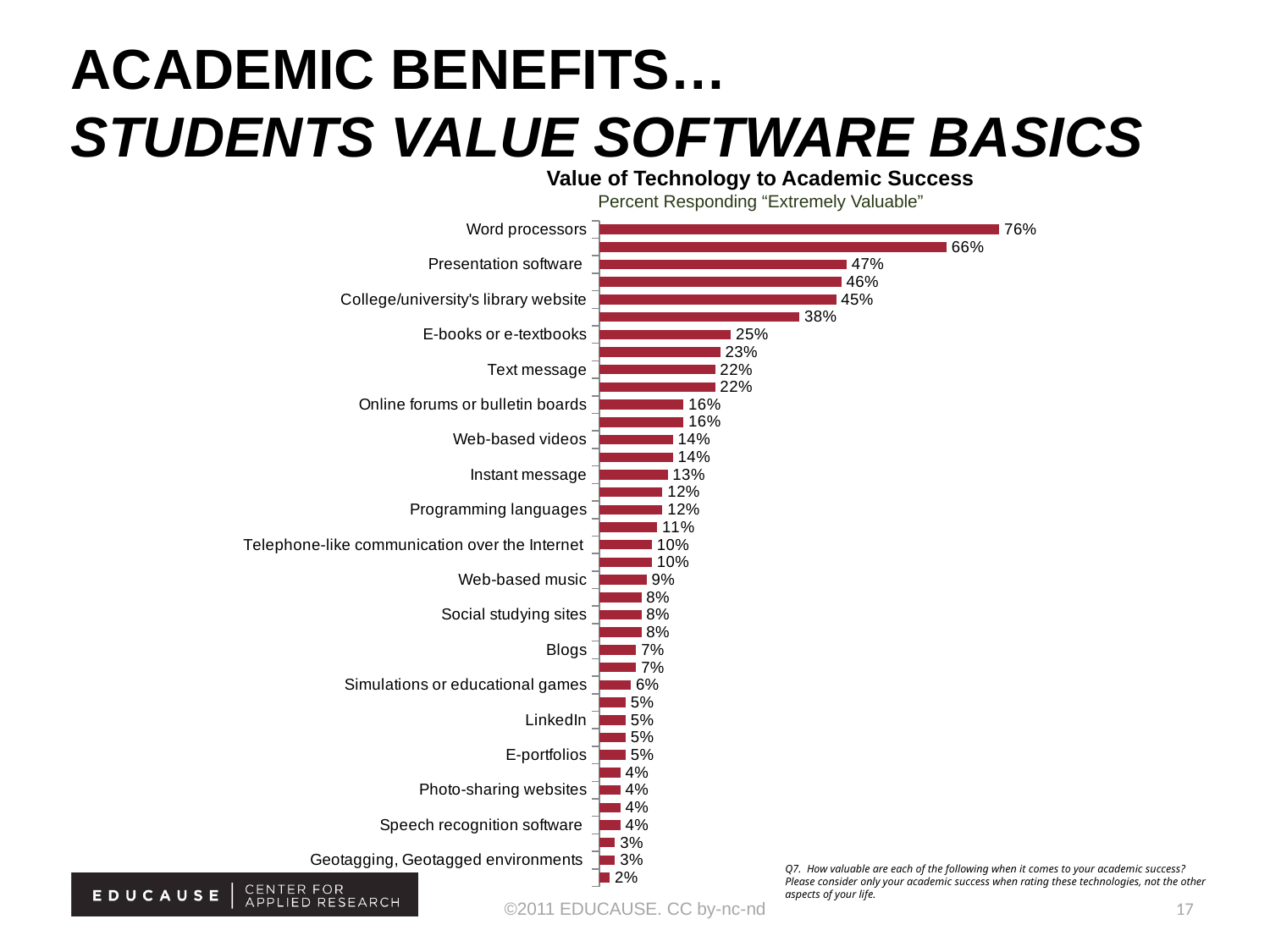
How many percentage points higher is word processors than presentation software? 29 percentage points Do the values rise or fall going from the top of the chart to the bottom? Fall What percentage is shown for e-books or e-textbooks? 25% What is the title of the chart? Value of Technology to Academic Success Which has a higher value, text message or web-based videos? Text message What kind of chart is shown on the slide? Bar chart What is the value for the college/university's library website? 45% What is the smallest value shown on the chart? 2% Which labeled technology has the highest percentage of students responding 'extremely valuable'? Word processors What is the value for speech recognition software? 4% What percentage of students rated word processors as extremely valuable? 76% What is the value shown for presentation software? 47%